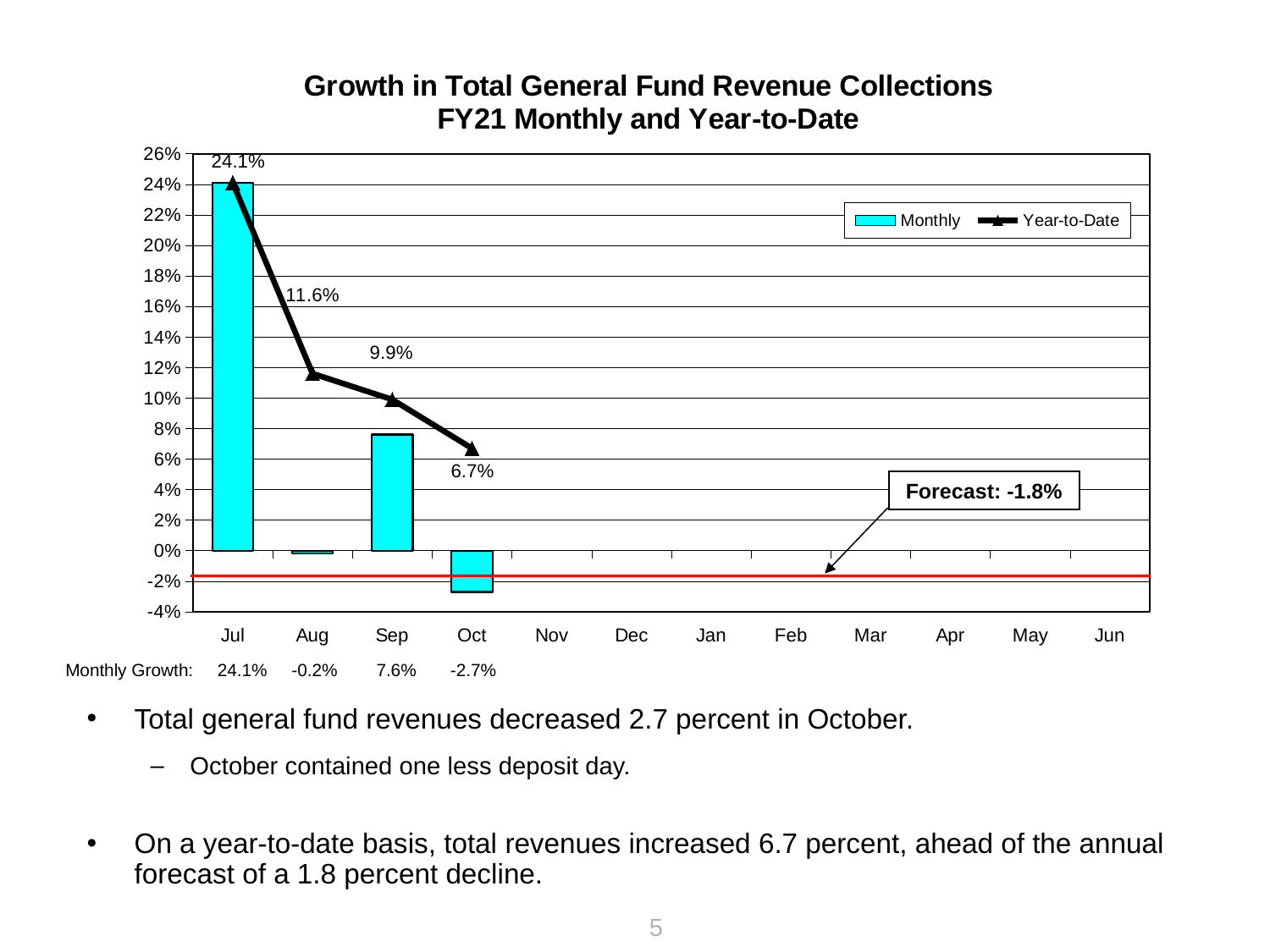
What is the Monthly growth value for Sep? 7.6% What is the Year-to-Date growth value for Oct? 6.7% Which is larger, the Monthly growth for Jul or for Sep? Jul What is the difference between the Year-to-Date growth for Aug and Sep? 1.7% Do the Year-to-Date values rise or fall from Jul to Oct? fall What is the Year-to-Date growth value for Jul? 24.1% Is the Year-to-Date value for Aug greater or less than 10%? greater What forecast value is shown on the chart? -1.8% Which month has the lowest Monthly growth? Oct How many series does the legend list? 2 What is the Monthly growth value for Oct? -2.7% Which month has the highest Year-to-Date growth? Jul